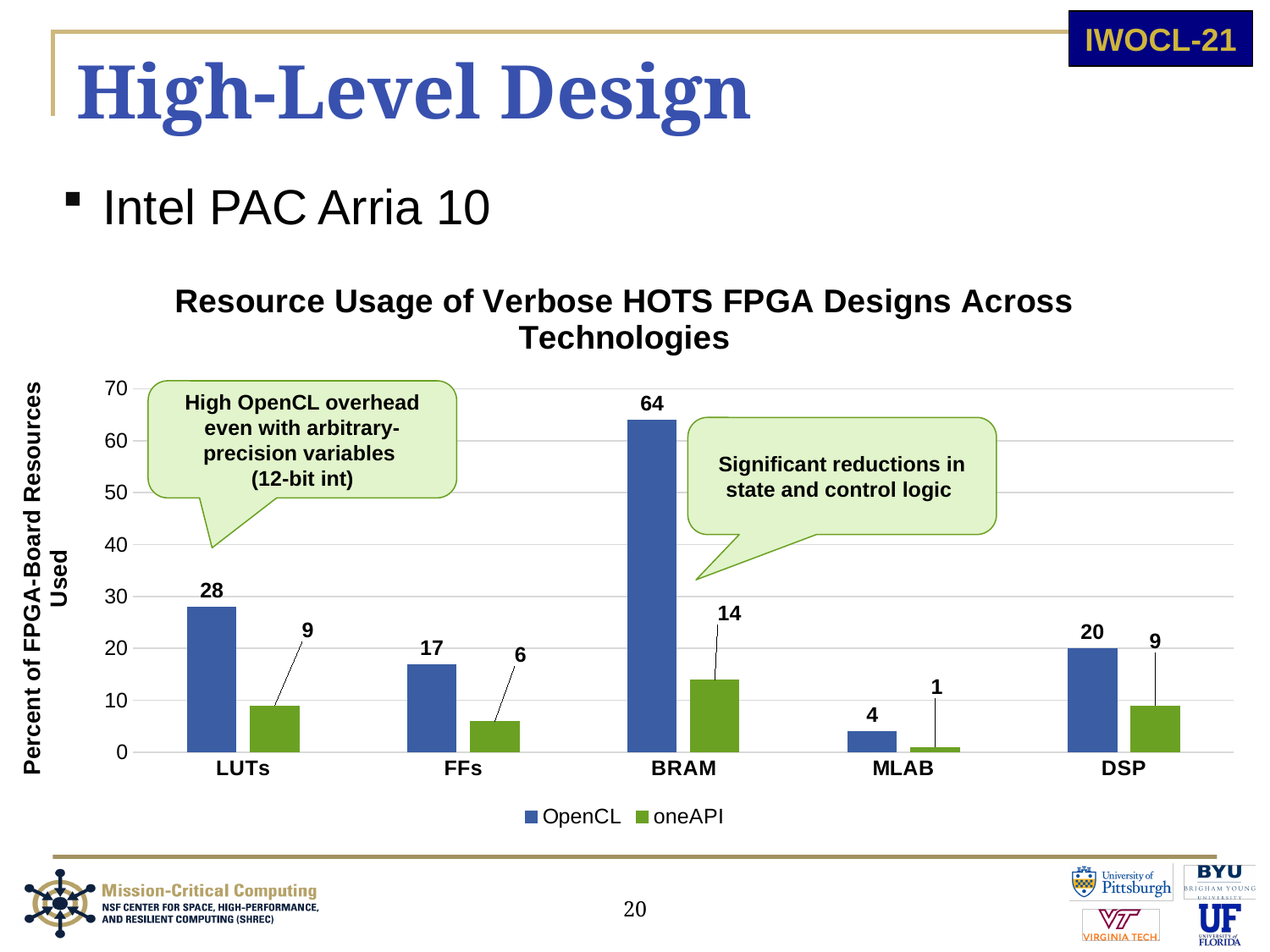
What is the difference between the OpenCL and oneAPI values for BRAM? 50 What kind of chart is shown on the slide? bar chart What is the oneAPI value for LUTs? 9 How many categories are shown on the x axis? 5 Which category has the highest OpenCL value? BRAM What is the OpenCL value for DSP? 20 What is the OpenCL value for BRAM? 64 What is the oneAPI value for MLAB? 1 What is the title of the chart? Resource Usage of Verbose HOTS FPGA Designs Across Technologies Which is larger for FFs, the OpenCL value or the oneAPI value? OpenCL Which category has the lowest oneAPI value? MLAB How many series does the legend list? 2